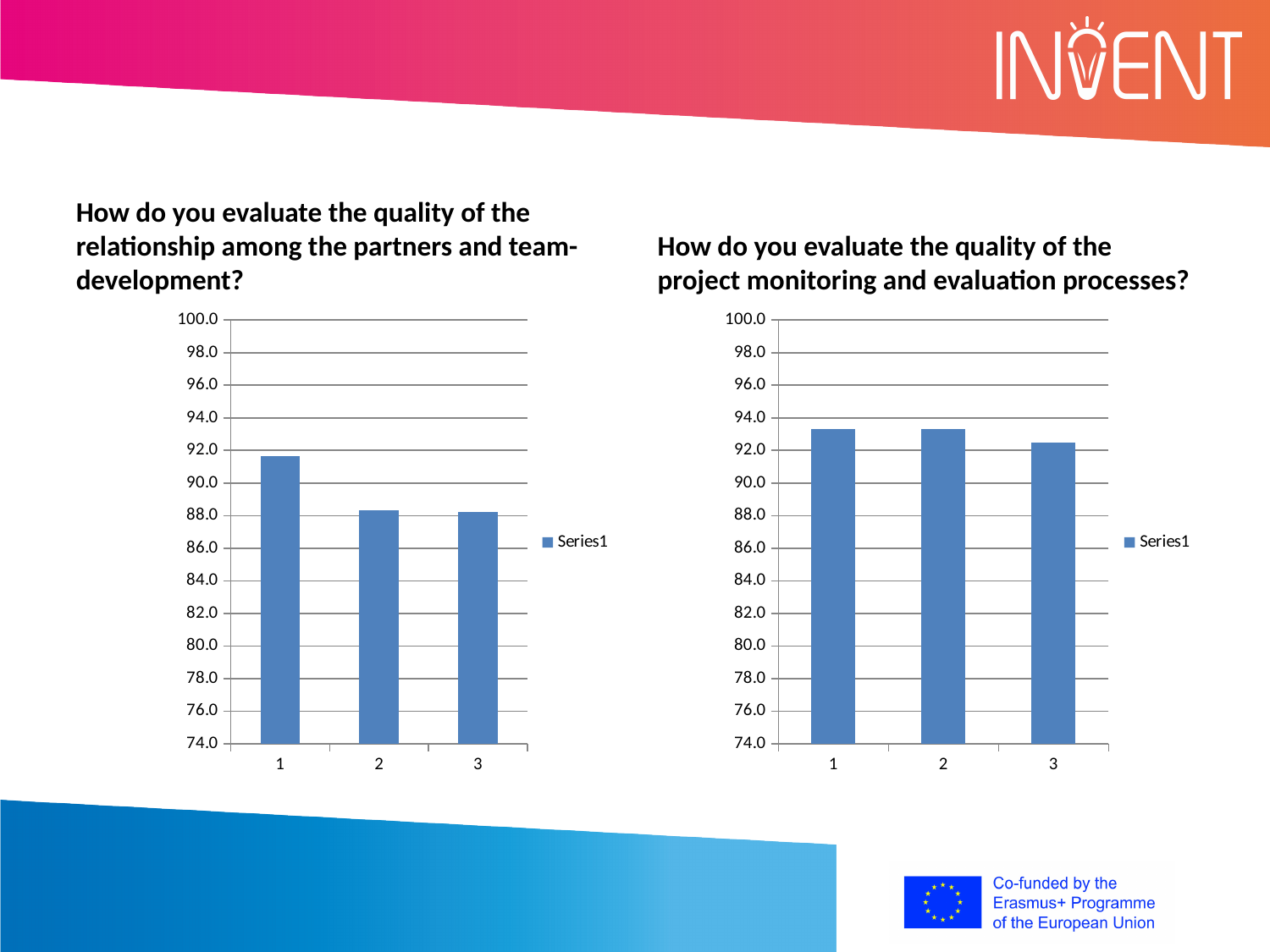
In the left chart (relationship among the partners and team-development), do the values rise or fall from category 1 to category 3? fall What kind of chart is shown under the title 'How do you evaluate the quality of the relationship among the partners and team-development?'? bar chart In the right chart (project monitoring and evaluation processes), is the value for category 3 greater or less than 94.0? less In the right chart (project monitoring and evaluation processes), how many series does the legend list? 1 In the right chart (project monitoring and evaluation processes), which category has the lowest value? 3 In the right chart (project monitoring and evaluation processes), is the value for category 1 greater or less than 92.0? greater In the left chart (relationship among the partners and team-development), is the value for category 2 greater or less than 90.0? less In the left chart (relationship among the partners and team-development), how many categories are plotted on the x axis? 3 In the left chart (relationship among the partners and team-development), which is larger, the value for category 1 or category 3? category 1 In the right chart (project monitoring and evaluation processes), what is the name of the series shown in the legend? Series1 In the left chart (relationship among the partners and team-development), which category has the highest value? 1